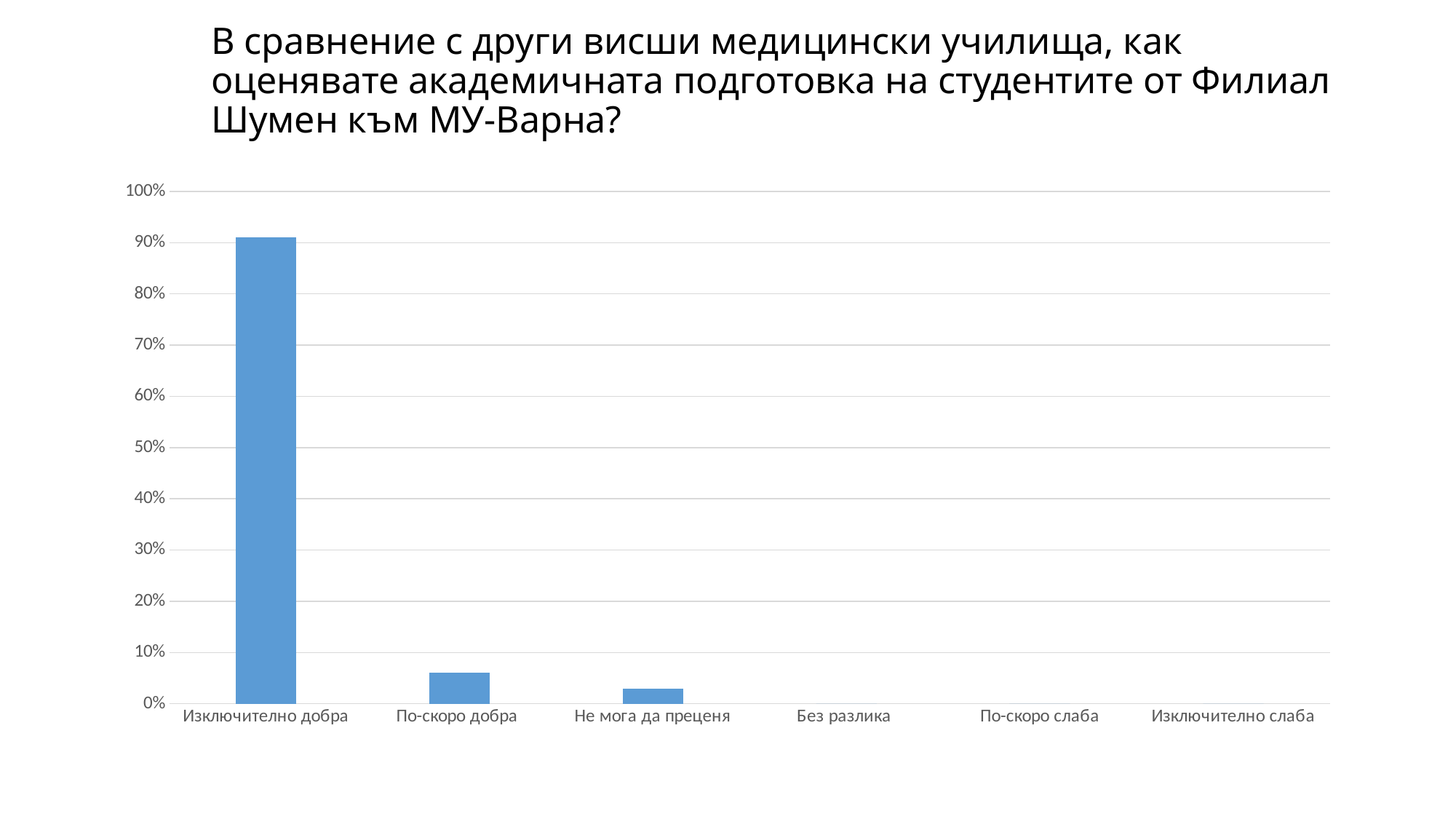
What is the highest value shown on the vertical axis of the chart? 100% Which is larger, the value for Изключително добра or the value for По-скоро добра? Изключително добра What colour are the bars in the chart? blue Is the value for Изключително добра greater or less than 100%? less How many categories are shown on the x axis of the chart? 6 What kind of chart is shown on the slide? bar chart Which is larger, the value for По-скоро добра or the value for Не мога да преценя? По-скоро добра Is the value for По-скоро добра greater or less than 10%? less Which category has the highest value in the chart? Изключително добра Is the value for Не мога да преценя greater or less than 10%? less